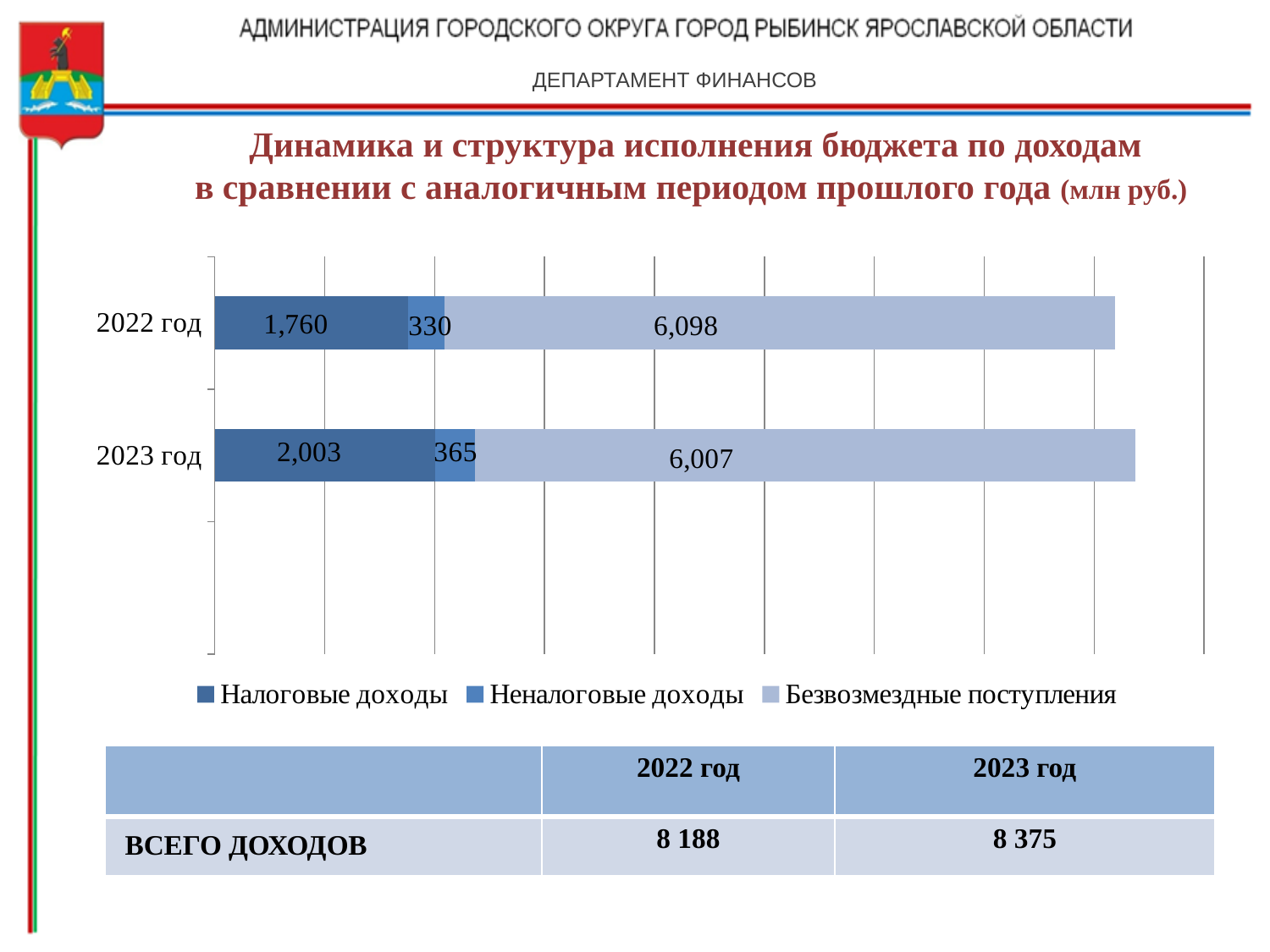
What kind of chart is shown on the slide? Stacked bar chart How many categories (years) are shown in the chart? 2 What is the difference between Неналоговые доходы in 2023 год and 2022 год? 35 How many series does the legend list? 3 Which year has the higher value for Налоговые доходы? 2023 год What is the value of Безвозмездные поступления for 2022 год? 6,098 Which year has the higher value for Безвозмездные поступления? 2022 год What is the value of Налоговые доходы for 2022 год? 1,760 What is the total of the stacked bar for 2022 год? 8,188 What is the value of Налоговые доходы for 2023 год? 2,003 What is the value of Неналоговые доходы for 2023 год? 365 By how much did Налоговые доходы increase from 2022 год to 2023 год? 243